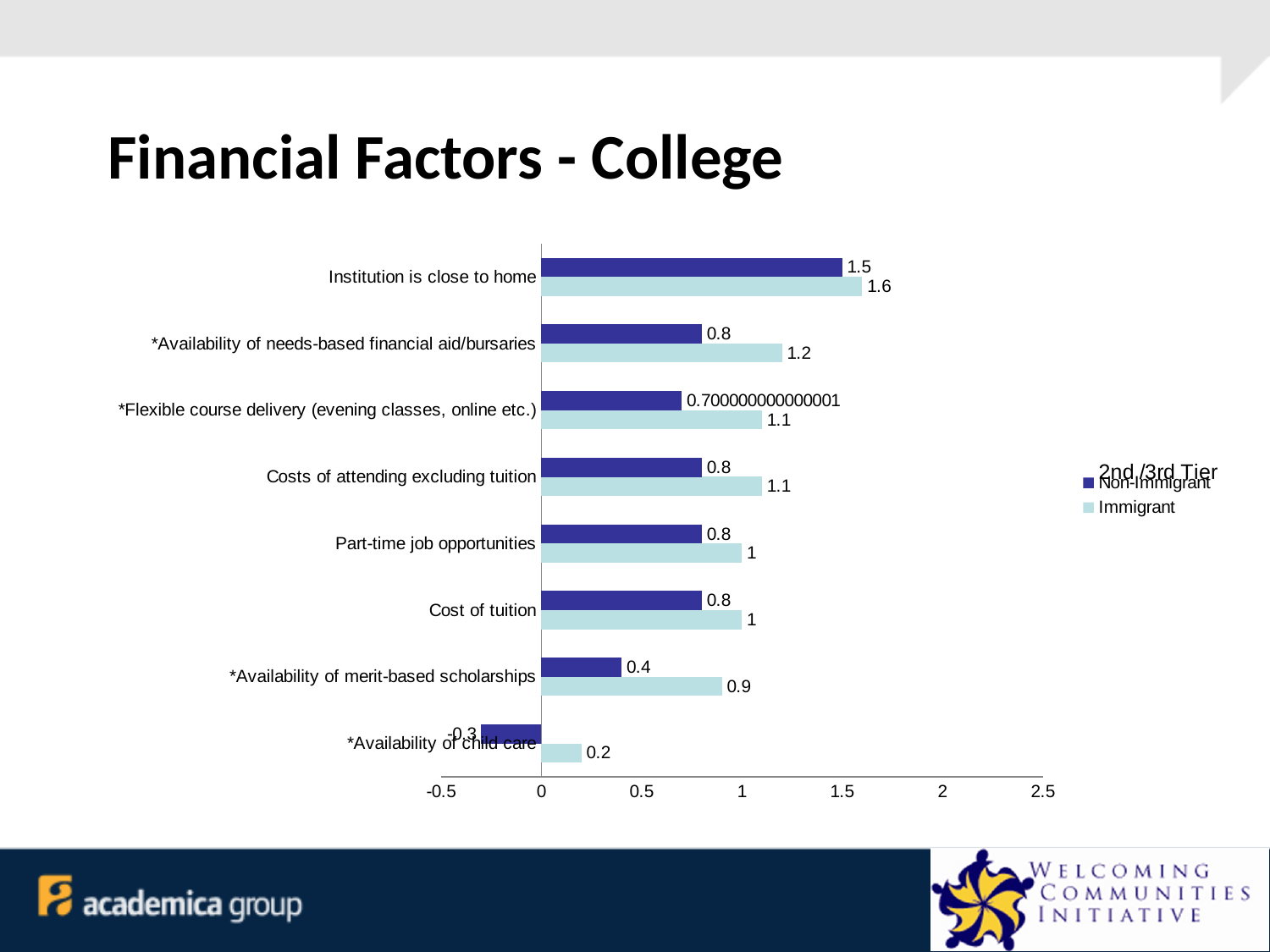
How many categories are shown on the chart? 8 For "*Availability of merit-based scholarships", which series has the larger value, Immigrant or Non-Immigrant? Immigrant Is the Non-Immigrant value for "*Availability of child care" greater or less than 0? less What is the Immigrant value for "Institution is close to home"? 1.6 What is the difference between the Immigrant and Non-Immigrant values for "Institution is close to home"? 0.1 What is the Immigrant value for "Part-time job opportunities"? 1 What is the Non-Immigrant value for "*Availability of needs-based financial aid/bursaries"? 0.8 How many series does the legend list? 2 Which category has the lowest Immigrant value? *Availability of child care Which category has the highest Immigrant value? Institution is close to home What type of chart is shown on the slide? Bar chart What is the difference between the Immigrant and Non-Immigrant values for "*Availability of needs-based financial aid/bursaries"? 0.4